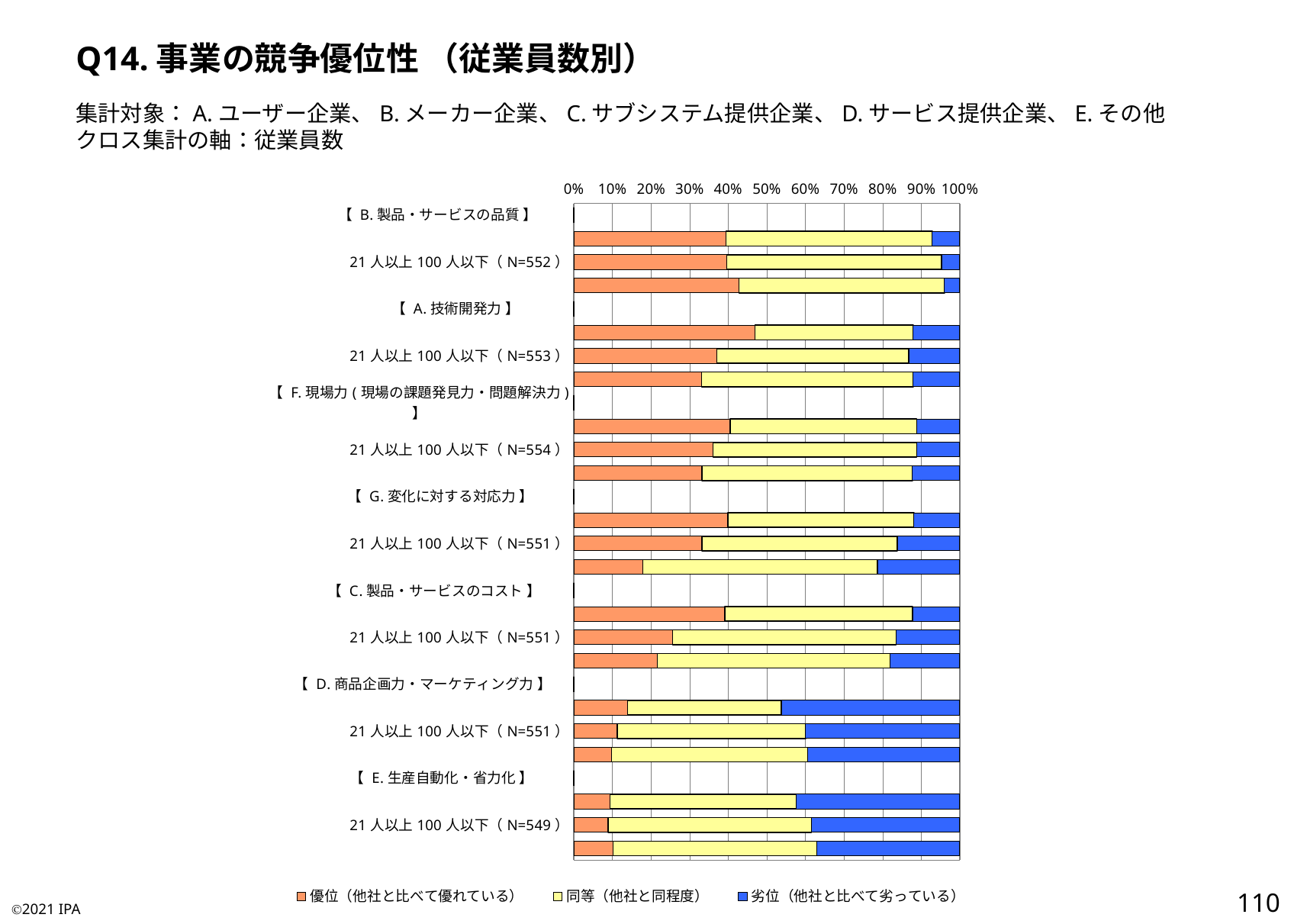
Is the 優位 share for the 21人以上100人以下 (N=549) row under 【E. 生産自動化・省力化】 greater or less than 20%? less How many series does the legend list? 3 What are the three legend entries of the chart? 優位（他社と比べて優れている）, 同等（他社と同程度）, 劣位（他社と比べて劣っている） What is the maximum value shown on the chart's horizontal axis? 100% Which has the larger 優位 share: the 21人以上100人以下 (N=552) row under 【B. 製品・サービスの品質】 or the 21人以上100人以下 (N=549) row under 【E. 生産自動化・省力化】? 21人以上100人以下 (N=552) under B. 製品・サービスの品質 What kind of chart is shown on the slide? stacked bar chart Is the 優位 share for the 21人以上100人以下 (N=551) row under 【D. 商品企画力・マーケティング力】 greater or less than 20%? less Which has the larger 劣位 share: the 21人以上100人以下 (N=551) row under 【D. 商品企画力・マーケティング力】 or the 21人以上100人以下 (N=552) row under 【B. 製品・サービスの品質】? 21人以上100人以下 (N=551) under D. 商品企画力・マーケティング力 How many labelled category groups (【 】 headings) are shown on the chart's vertical axis? 7 How many bars are plotted under each 【 】 category heading? 3 Is the 優位 share for the 21人以上100人以下 (N=553) row under 【A. 技術開発力】 greater or less than 30%? greater